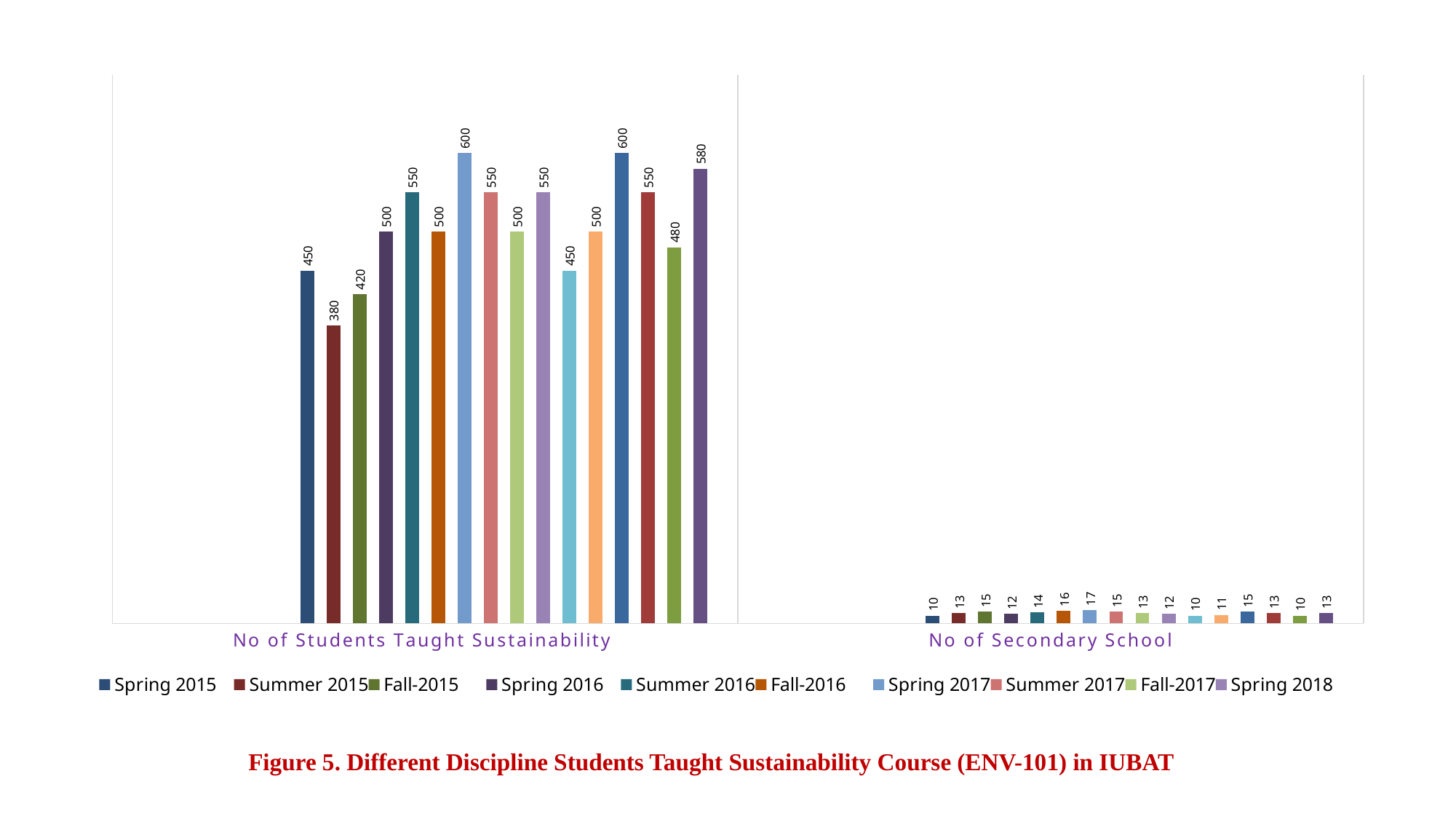
Which series has the lowest value in the 'No of Students Taught Sustainability' category? Summer 2015 What is the value for Spring 2015 in the 'No of Students Taught Sustainability' category? 450 What is the value for Summer 2015 in the 'No of Students Taught Sustainability' category? 380 How many series does the legend list? 10 What is the value for Fall-2016 in the 'No of Secondary School' category? 16 Which is larger in the 'No of Students Taught Sustainability' category, Summer 2016 or Fall-2015? Summer 2016 What kind of chart is shown on the slide? bar chart Which series has the highest value in the 'No of Secondary School' category? Spring 2017 What is the difference between Spring 2017 and Summer 2015 in the 'No of Students Taught Sustainability' category? 220 How many categories are shown on the x axis? 2 What is the figure caption below the chart? Figure 5. Different Discipline Students Taught Sustainability Course (ENV-101) in IUBAT What is the value for Spring 2017 in the 'No of Secondary School' category? 17